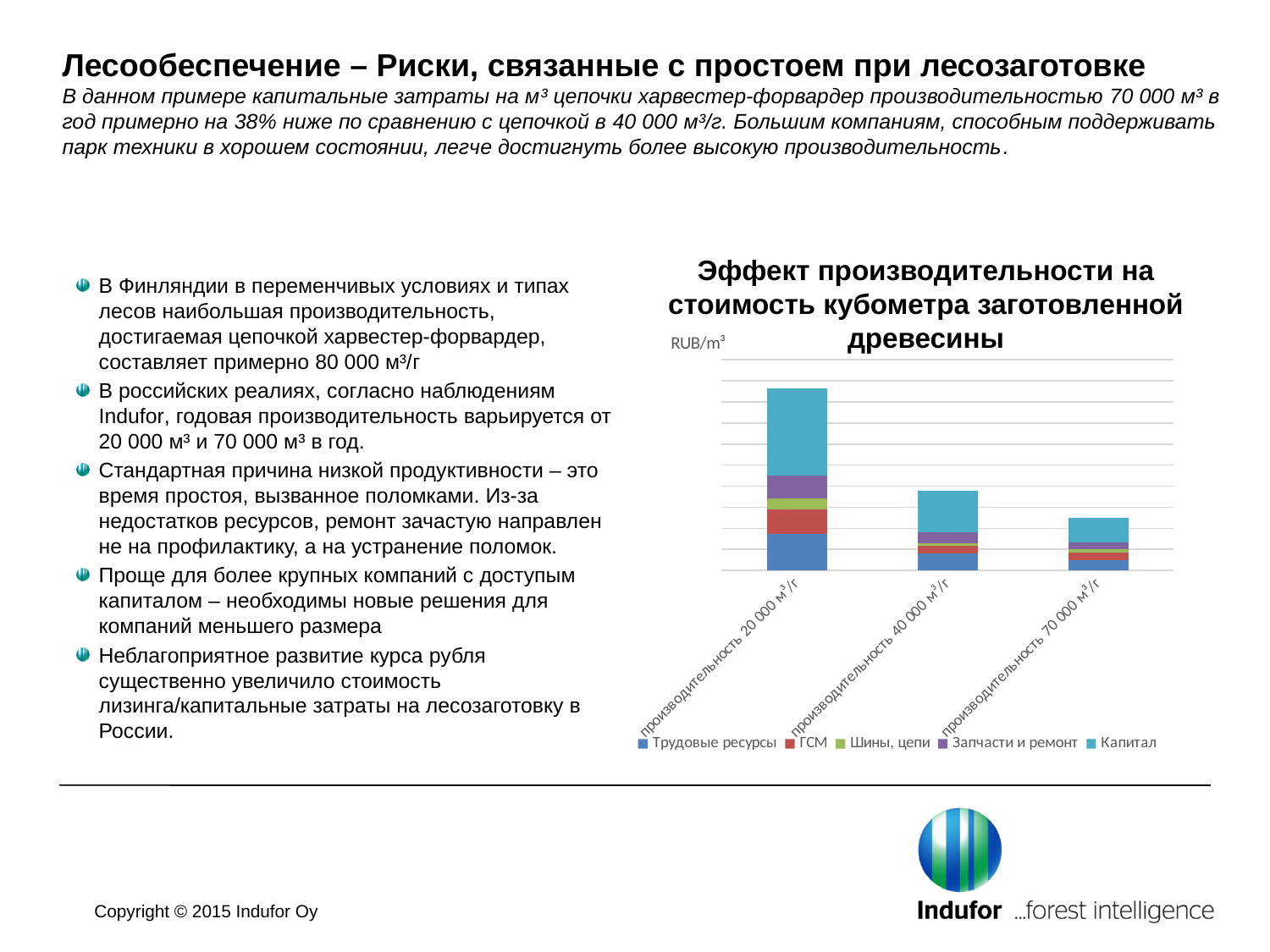
What unit is shown on the chart's vertical axis? RUB/m³ Which bar is taller: производительность 20 000 м³/г or производительность 40 000 м³/г? производительность 20 000 м³/г Which productivity category has the lowest total cost per cubic metre? производительность 70 000 м³/г What kind of chart is shown on the slide? Stacked bar chart Do the total bar heights rise or fall as productivity increases along the x axis? Fall Which productivity category has the highest total cost per cubic metre? производительность 20 000 м³/г How many series does the chart's legend list? 5 Which series forms the largest segment of the производительность 20 000 м³/г bar? Капитал How many productivity categories are plotted on the x axis of the chart? 3 Which series is shown at the bottom of each stacked bar? Трудовые ресурсы